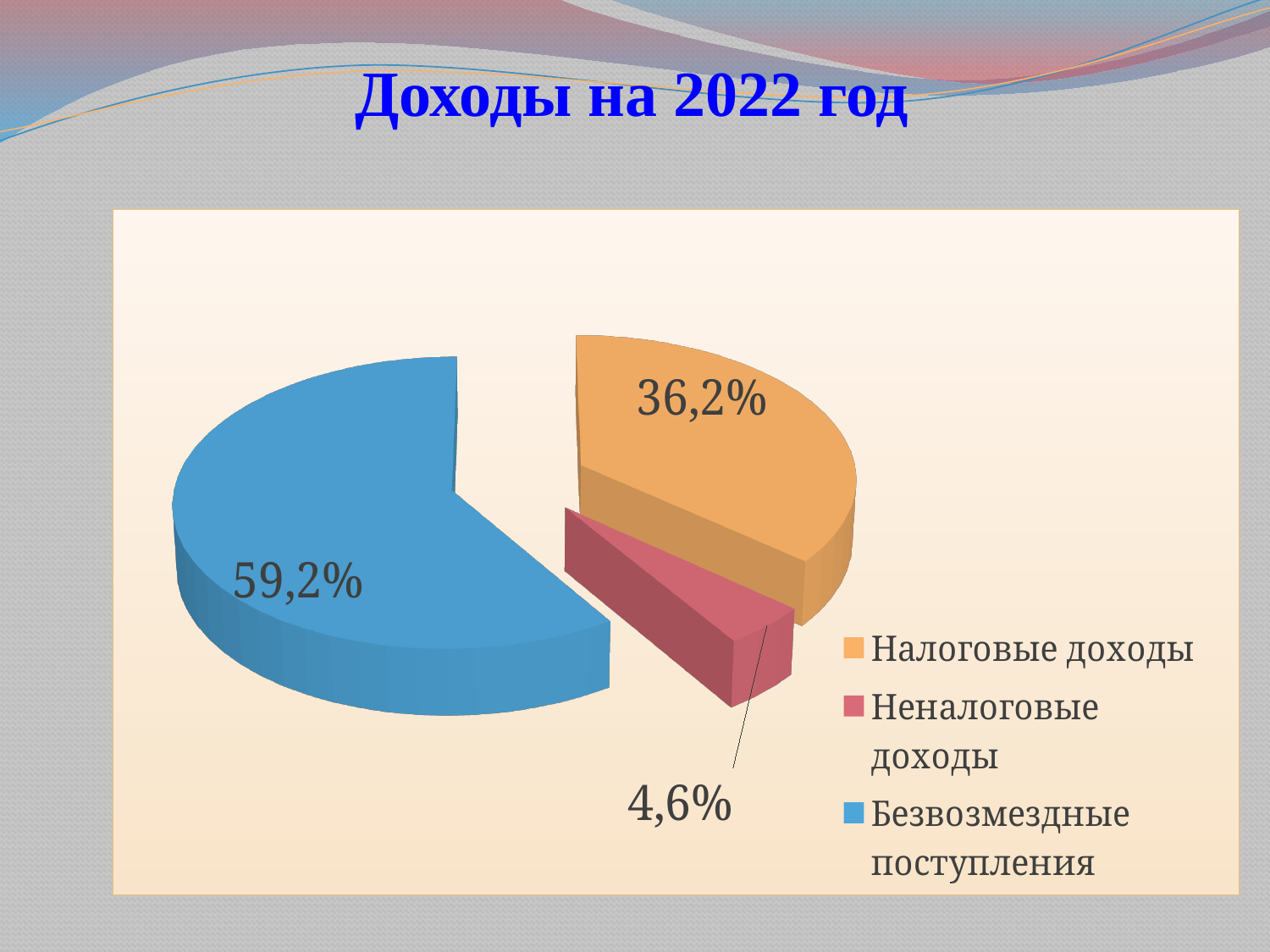
What is the difference in percentage points between Безвозмездные поступления and Налоговые доходы? 23 percentage points How many slices does the pie chart have? 3 What share of the pie does Неналоговые доходы have? 4,6% What share of the pie does Налоговые доходы have? 36,2% What colour is the slice for Безвозмездные поступления? blue What kind of chart is shown on the slide? pie chart What share of the pie does Безвозмездные поступления have? 59,2% Which is larger, the share for Налоговые доходы or the share for Неналоговые доходы? Налоговые доходы Which category has the largest slice of the pie? Безвозмездные поступления What is the title of the slide containing the chart? Доходы на 2022 год What is the difference in percentage points between Налоговые доходы and Неналоговые доходы? 31,6 percentage points Which category has the smallest slice of the pie? Неналоговые доходы